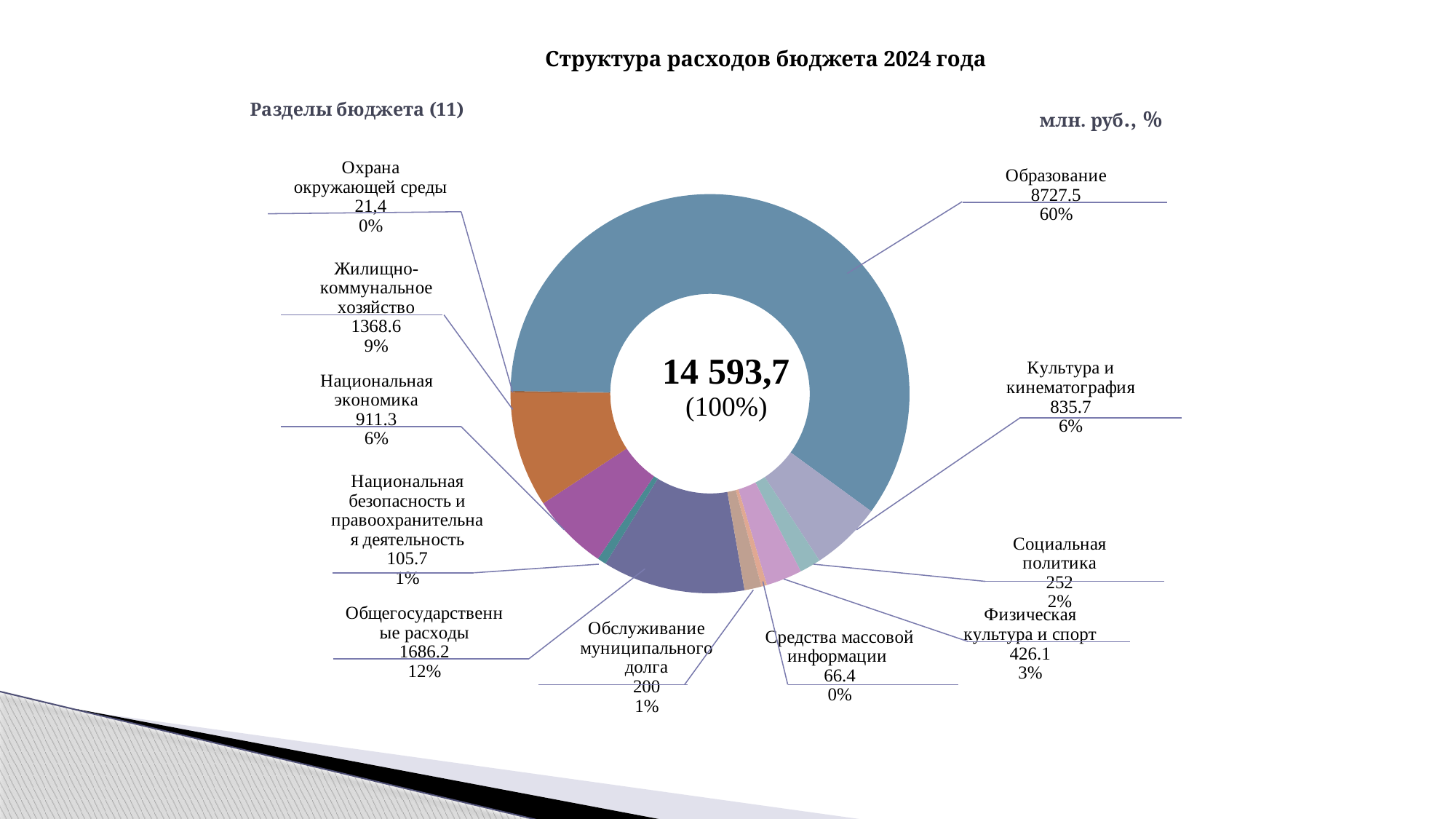
What is the value for Общегосударственные расходы? 1686.2 Which is larger: Национальная экономика or Культура и кинематография? Национальная экономика What share of the budget does Образование account for? 60% What is the total value shown in the centre of the chart? 14 593,7 What is the difference between Общегосударственные расходы and Жилищно-коммунальное хозяйство? 317.6 What is the value for Жилищно-коммунальное хозяйство? 1368.6 Which budget section has the smallest value? Охрана окружающей среды Which budget section has the largest value? Образование How many budget sections are shown in the chart? 11 What is the value for Образование in the chart? 8727.5 What is the title of the chart? Разделы бюджета (11) What type of chart is shown on the slide? Donut (pie) chart